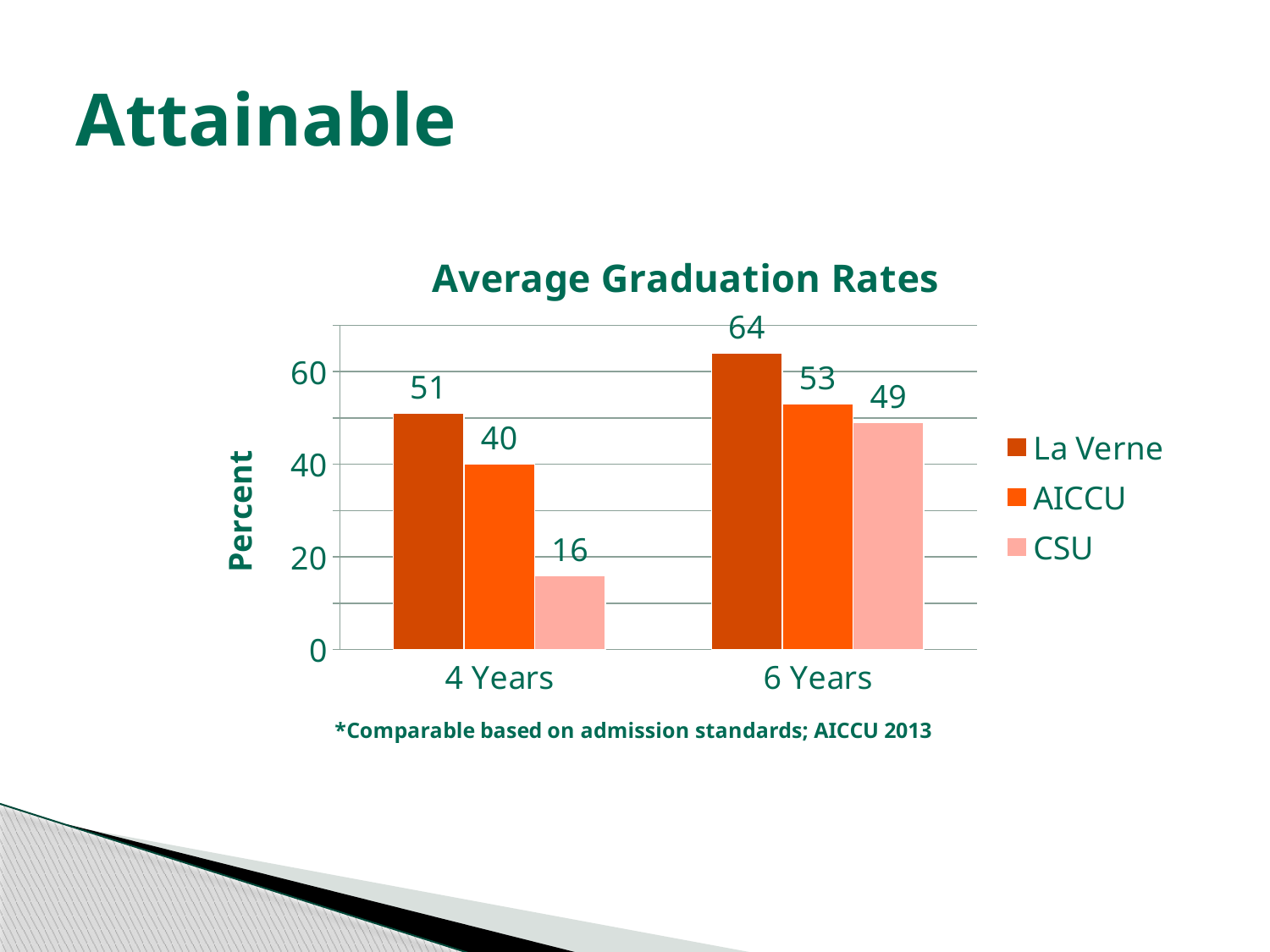
What is the 4 Years graduation rate for La Verne? 51 What is the difference between the 6 Years and 4 Years values for AICCU? 13 How many series does the legend list? 3 Which is larger: the AICCU value at 6 Years or the La Verne value at 4 Years? AICCU at 6 Years What is the 6 Years graduation rate for CSU? 49 Which series has the highest value at 6 Years? La Verne What kind of chart is shown? Bar chart What is the 4 Years value for AICCU? 40 Which series has the lowest value at 4 Years? CSU How many categories are shown on the x axis? 2 What is the title of the chart? Average Graduation Rates What is the difference between the La Verne and CSU values at 4 Years? 35